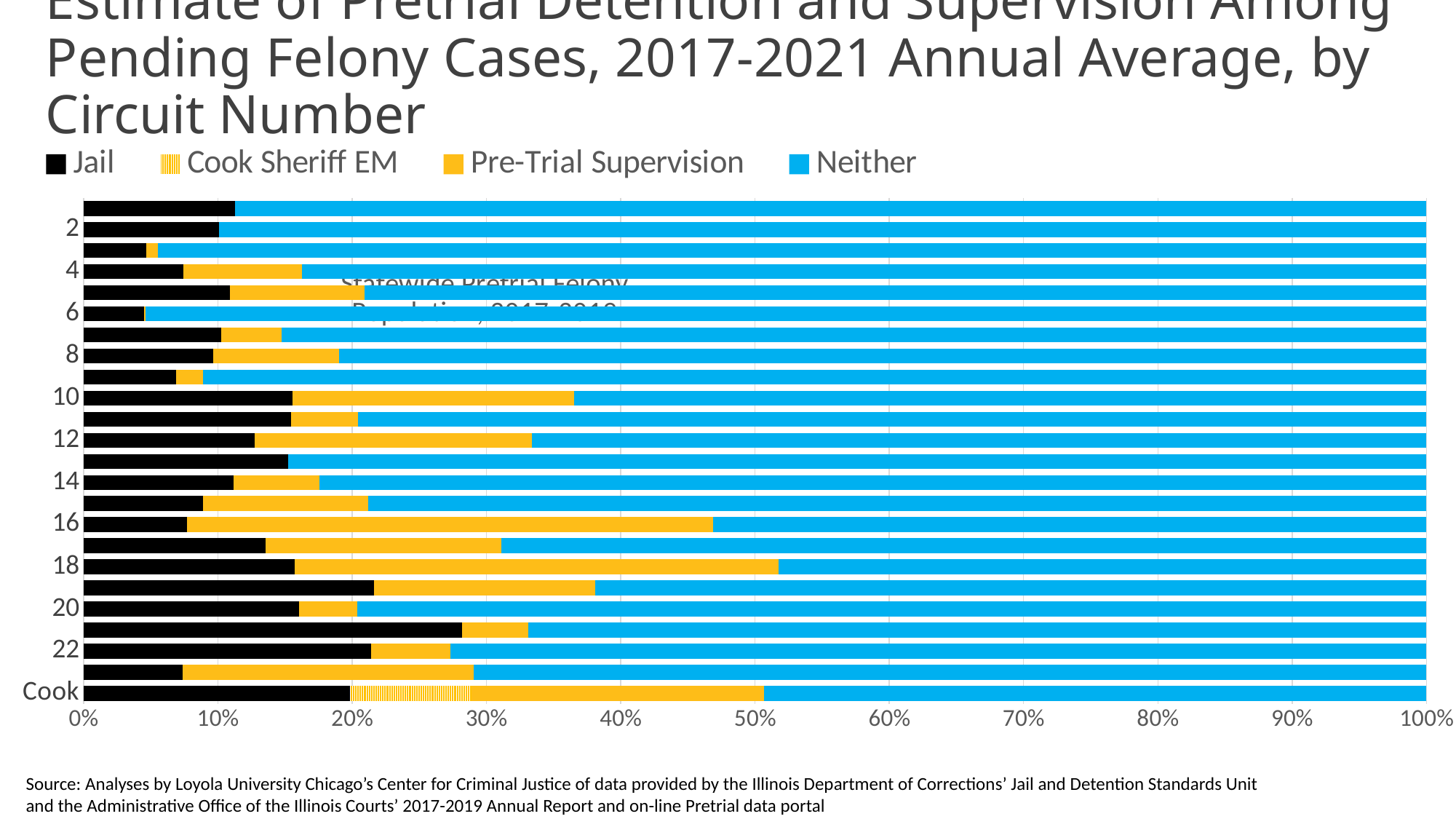
How many series does the legend list? 4 Is the Neither share for circuit 2 greater or less than 80%? greater Which series is shown in blue in the legend? Neither Which has the larger Neither share, circuit 2 or circuit 18? Circuit 2 Is the Jail share for Cook greater or less than 10%? greater Is the Jail share for circuit 6 greater or less than 10%? less Which category is the only one with a Cook Sheriff EM segment? Cook Which has the larger Pre-Trial Supervision share, circuit 16 or circuit 14? Circuit 16 What kind of chart is shown on the slide? Stacked bar chart What is the highest value shown on the horizontal axis? 100%